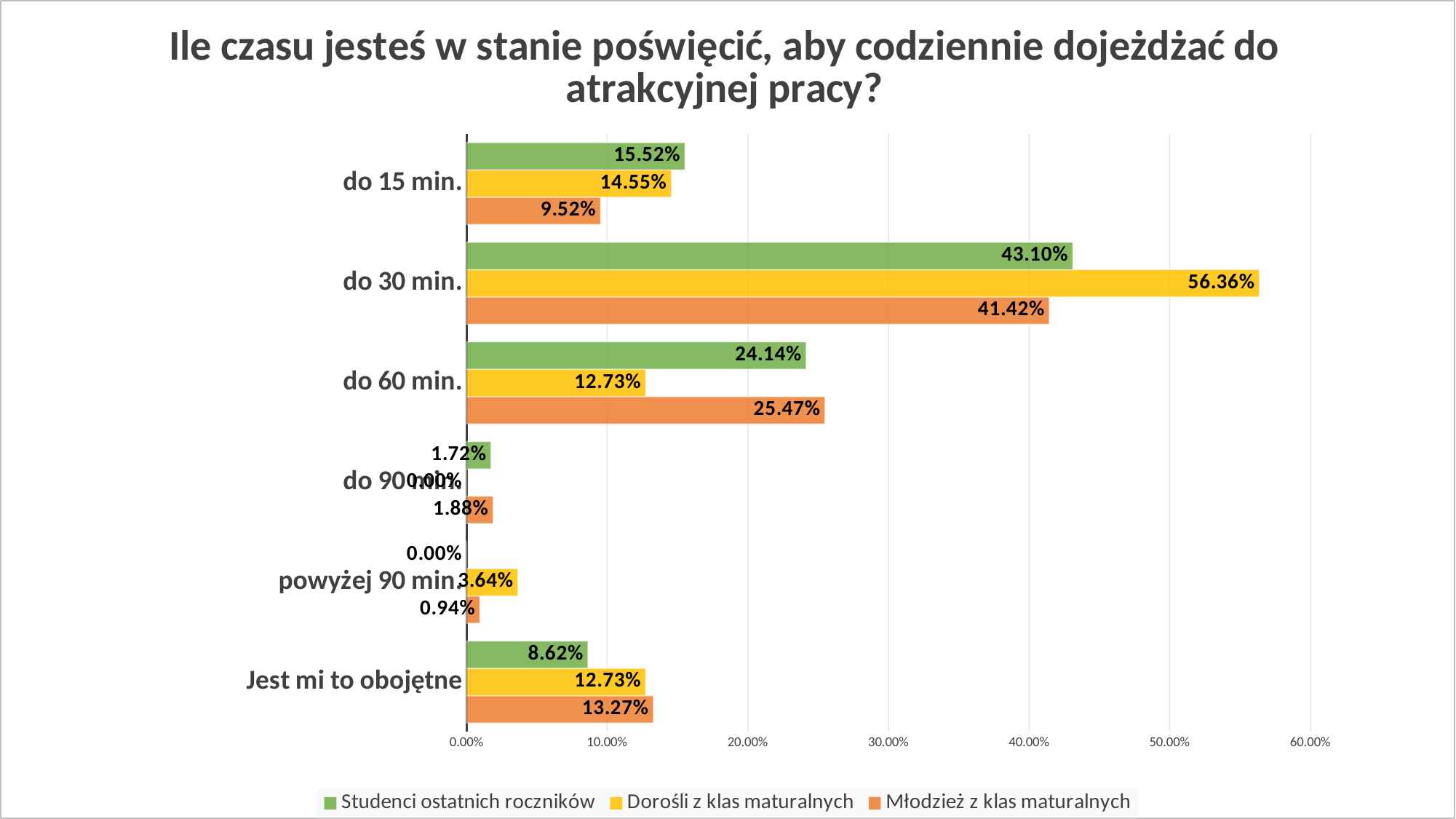
How many categories are shown on the chart? 6 Which category has the highest value for Studenci ostatnich roczników? do 30 min. What is the value for Młodzież z klas maturalnych in the 'do 60 min.' category? 25.47% Is the value for Młodzież z klas maturalnych in the 'do 30 min.' category greater or less than 40.00%? greater What is the value for Dorośli z klas maturalnych in the 'do 30 min.' category? 56.36% What type of chart is shown on the slide? bar chart Which colour represents Dorośli z klas maturalnych in the chart? yellow How many series does the legend list? 3 What is the difference between Dorośli z klas maturalnych and Studenci ostatnich roczników in the 'do 30 min.' category? 13.26% What is the value for Studenci ostatnich roczników in the 'Jest mi to obojętne' category? 8.62% Which category has the lowest value for Młodzież z klas maturalnych? powyżej 90 min. In the 'do 15 min.' category, which series has a larger value: Studenci ostatnich roczników or Młodzież z klas maturalnych? Studenci ostatnich roczników